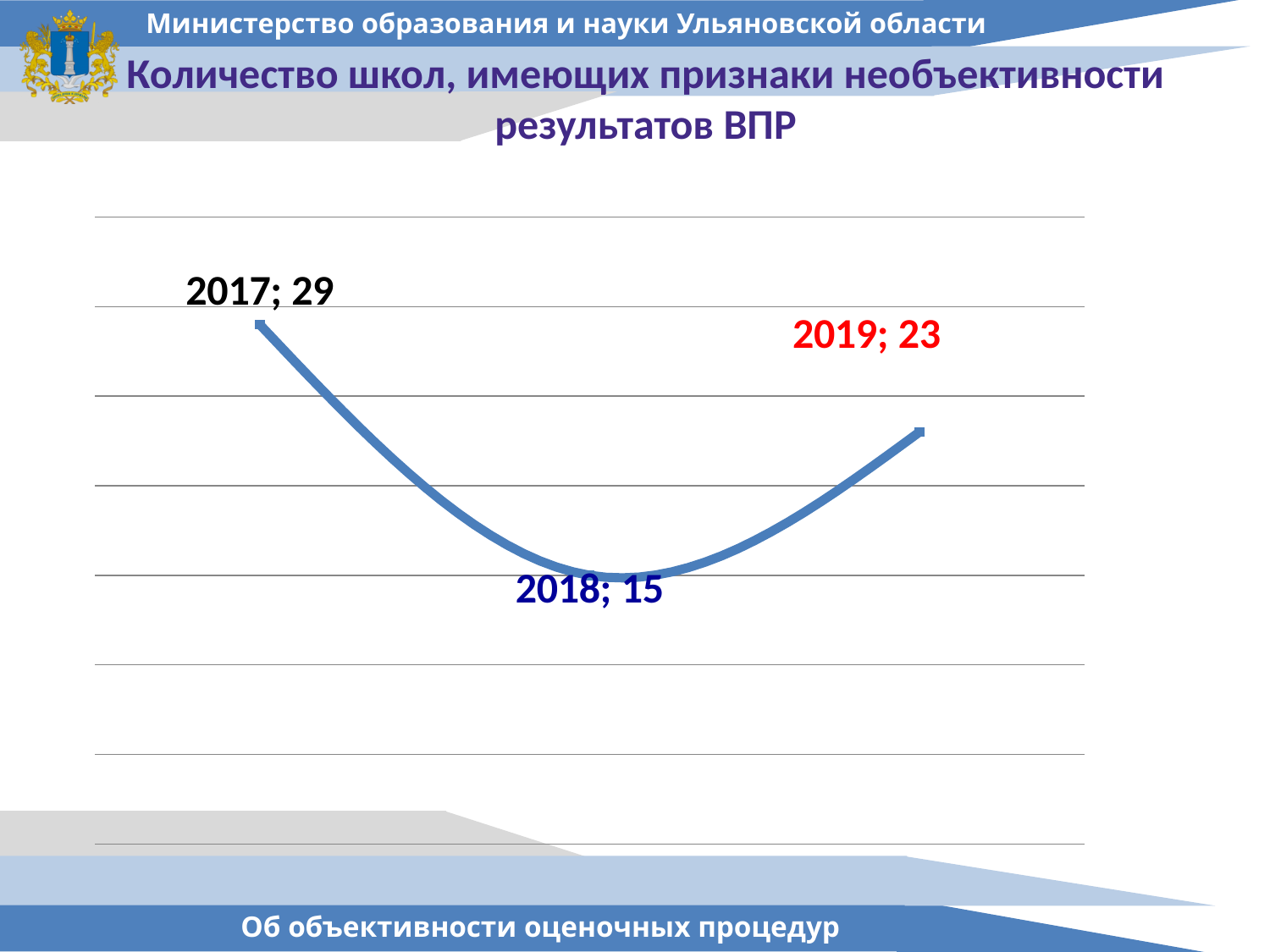
How many data points are plotted on the chart? 3 What is the difference between the values for 2019 and 2018? 8 What is the value for 2017? 29 Which year has the highest value? 2017 Which year has the lowest value? 2018 What is the value for 2019? 23 What is the difference between the values for 2017 and 2018? 14 What kind of chart is shown on the slide? line chart What is the value for 2018? 15 Does the value rise or fall from 2018 to 2019? rise What is the title of the chart? Количество школ, имеющих признаки необъективности результатов ВПР Which is larger, the value for 2017 or the value for 2019? 2017